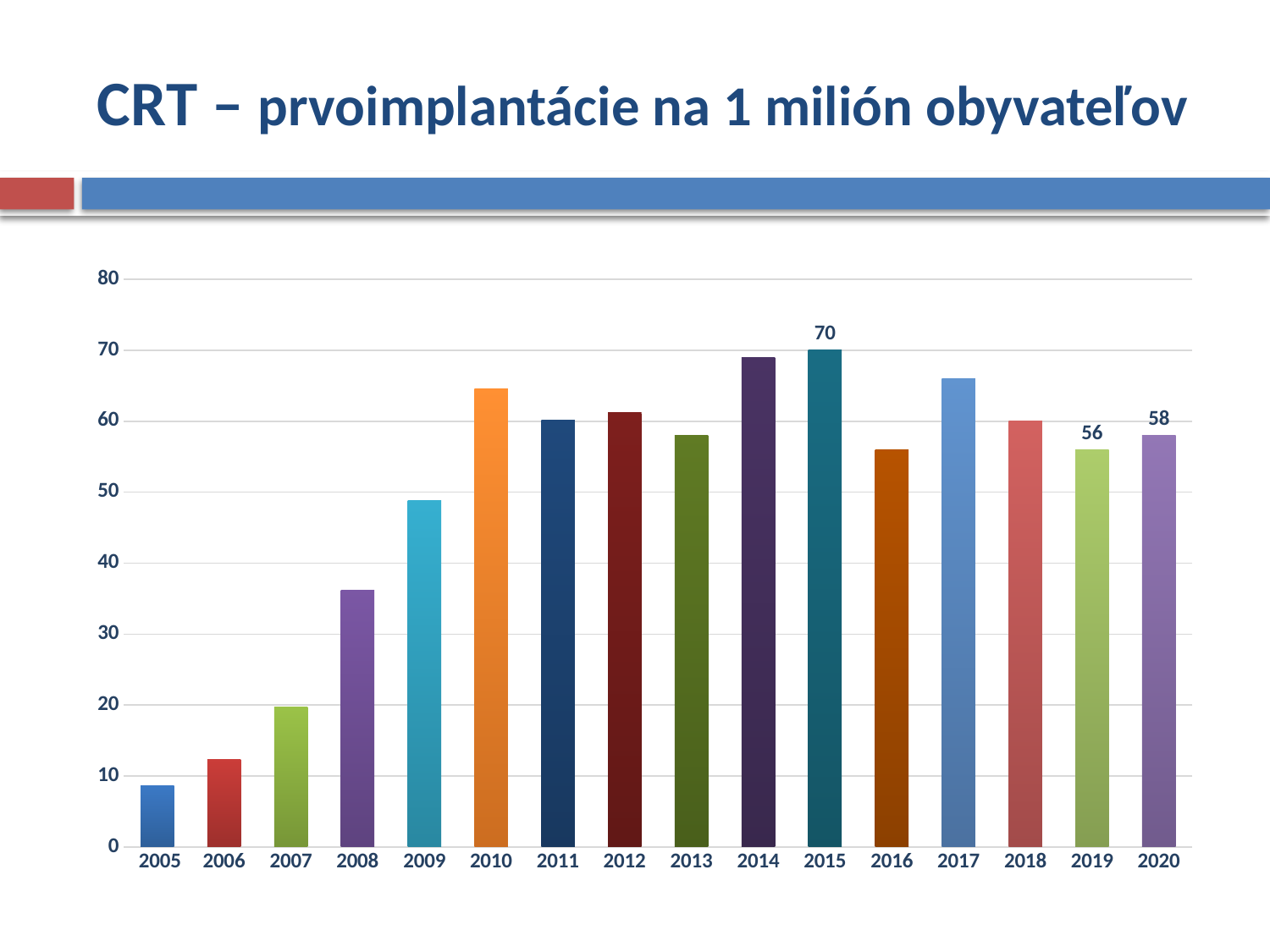
What is the value for 2020? 58 What is the value for 2019? 56 What is the value for 2015? 70 Which is larger, the value for 2019 or the value for 2020? 2020 Is the value for 2009 greater or less than 50? less What kind of chart is shown on the slide? bar chart What is the difference between the values for 2020 and 2019? 2 How many years are shown on the x axis? 16 Is the value for 2005 greater or less than 10? less Is the value for 2010 greater or less than 60? greater What is the difference between the values for 2015 and 2019? 14 Which year has the lowest value? 2005